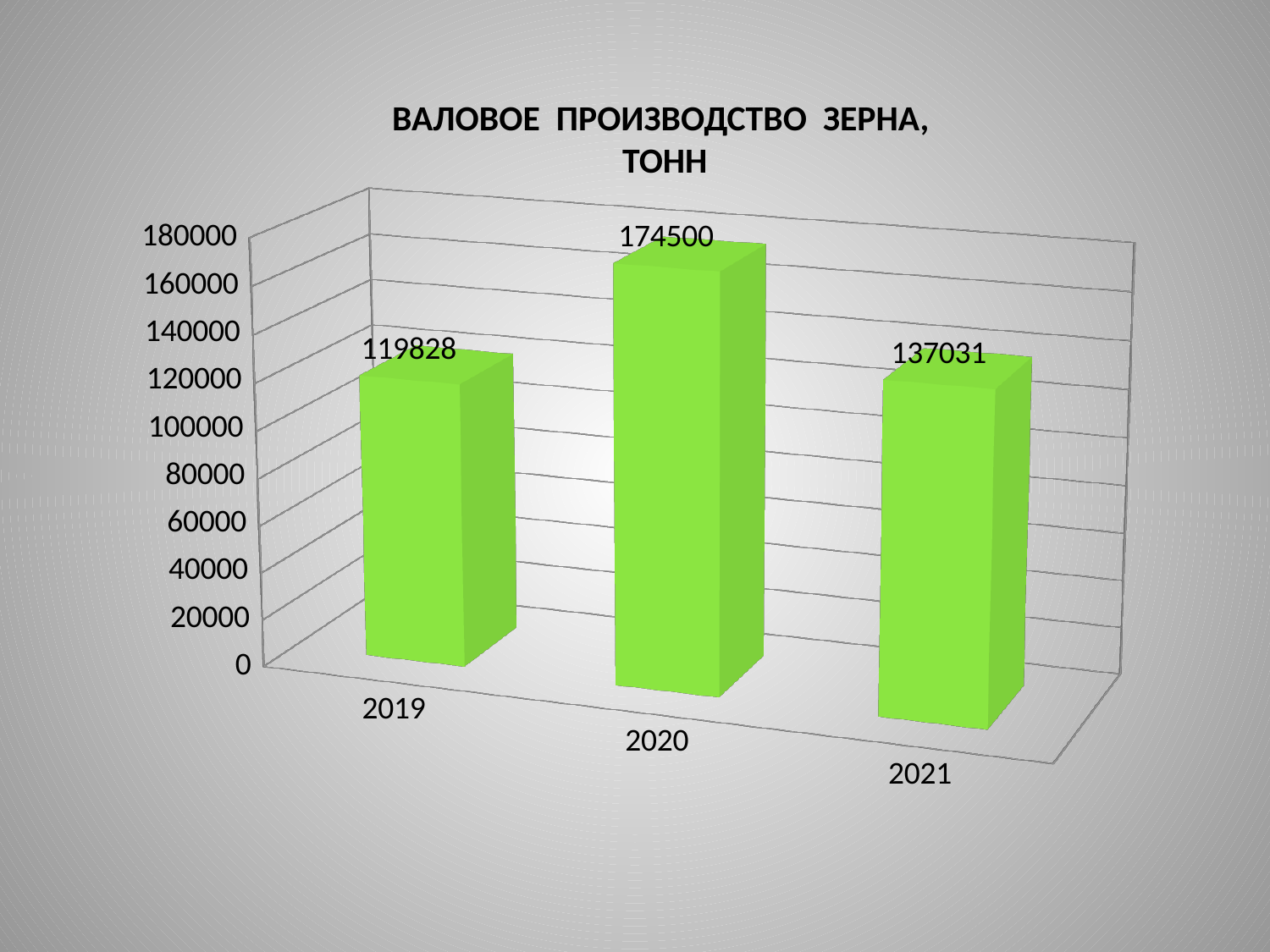
What is the title of the chart? ВАЛОВОЕ ПРОИЗВОДСТВО ЗЕРНА, ТОНН Is the value for 2021 greater or less than 140000? less What is the gross grain production value shown for 2020? 174500 What is the difference between the 2020 and 2019 values? 54672 Which year has the lowest gross grain production? 2019 How many years are shown on the chart? 3 What kind of chart is shown on the slide? bar chart What is the difference between the 2021 and 2019 values? 17203 What is the value shown for 2021? 137031 Which year has the highest gross grain production? 2020 What is the value shown for 2019? 119828 Which is larger, the value for 2021 or the value for 2019? 2021